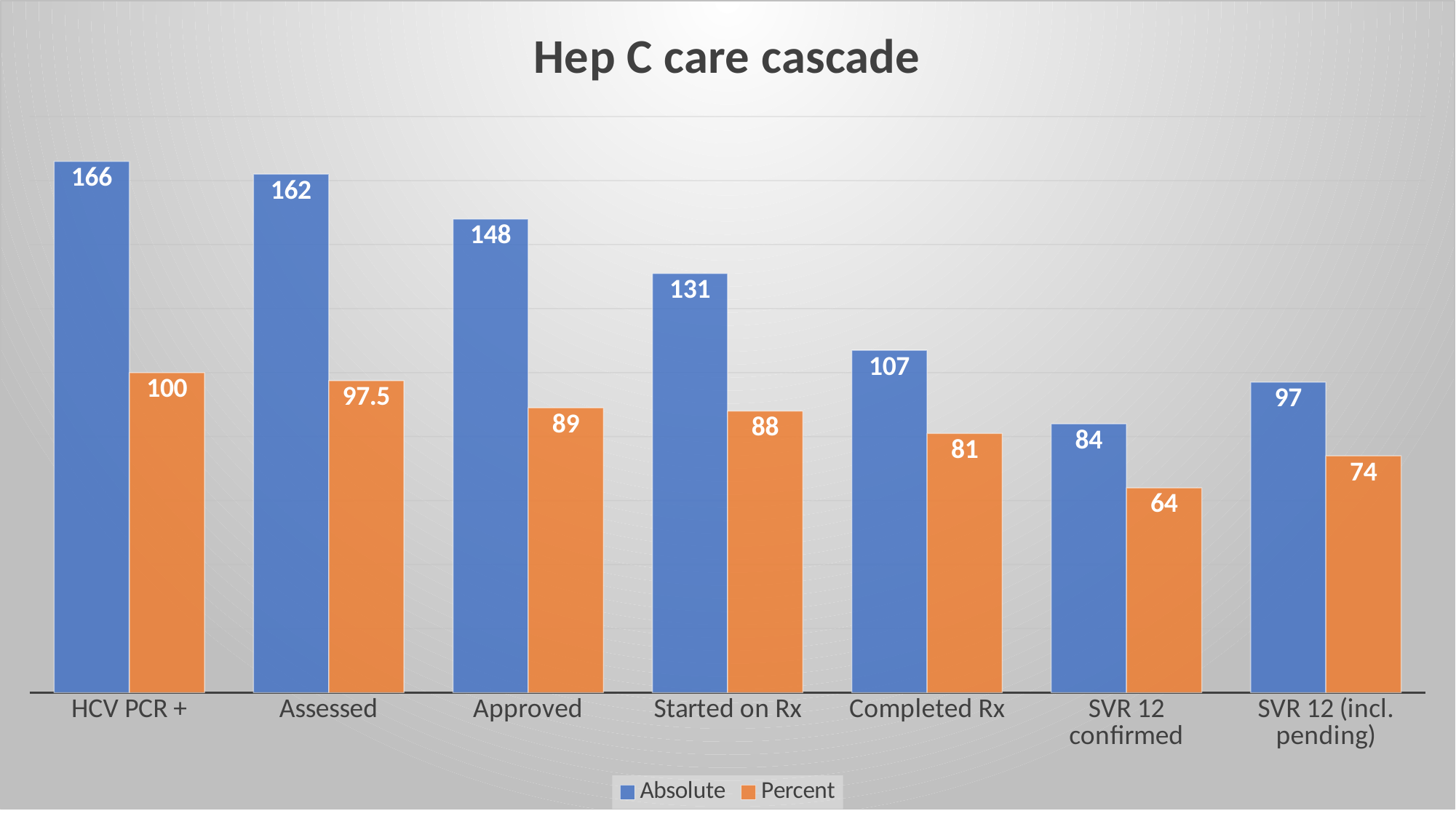
What is the Absolute value for SVR 12 (incl. pending)? 97 How many categories are shown on the x axis? 7 Which category has the lowest Percent value? SVR 12 confirmed What kind of chart is this? Bar chart What is the Absolute value for Started on Rx? 131 What is the Percent value for Assessed? 97.5 What is the title of the chart? Hep C care cascade Which is larger, the Absolute value for Approved or the Absolute value for Started on Rx? Approved Which category has the highest Absolute value? HCV PCR + What is the difference between the Absolute values for HCV PCR + and Completed Rx? 59 How many series does the legend list? 2 What is the Percent value for SVR 12 confirmed? 64